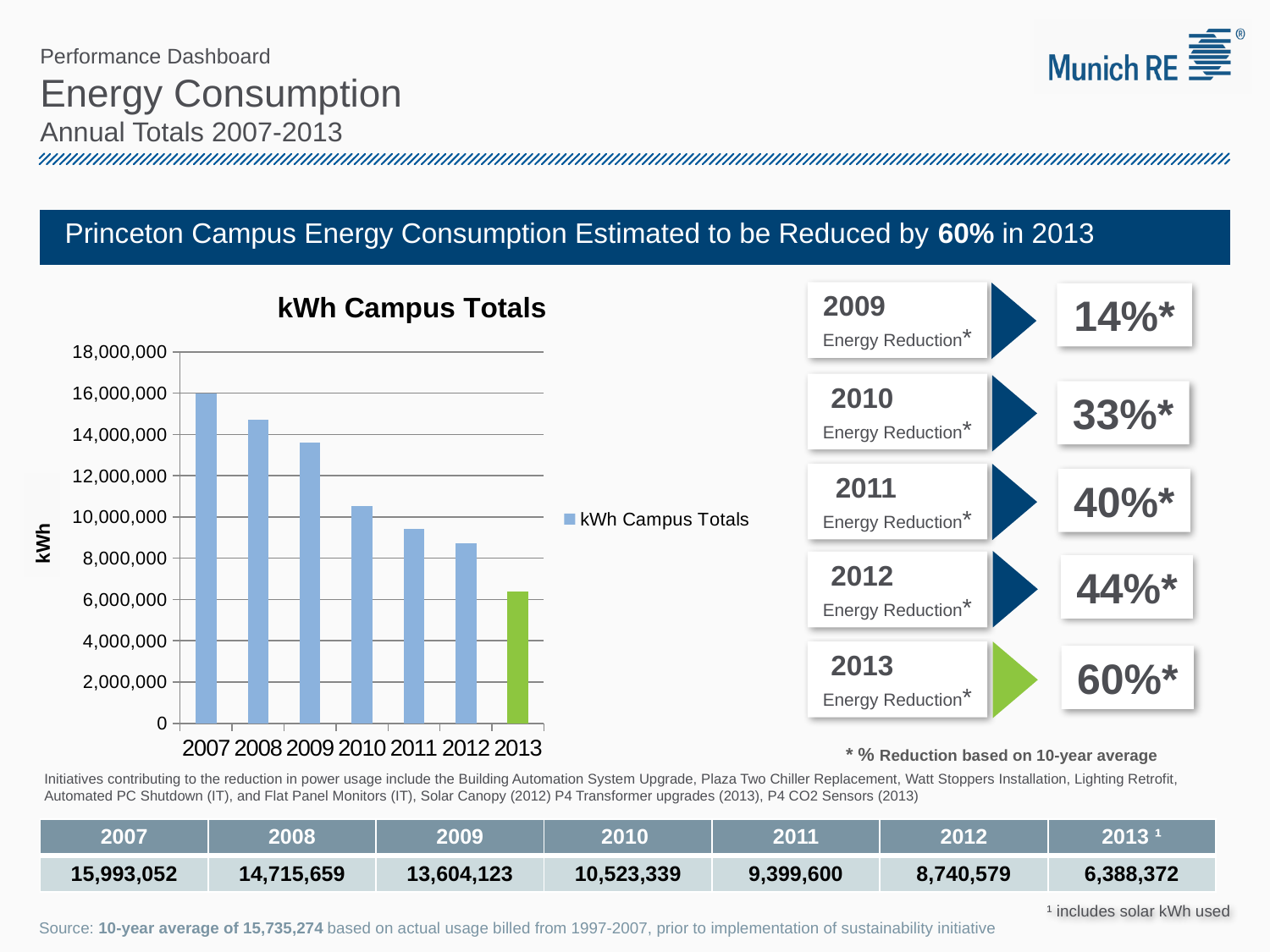
What colour is the bar for 2013 in the kWh Campus Totals chart? green How many series does the legend of the kWh Campus Totals chart list? 1 What is the kWh Campus Total for 2013 as printed on the slide? 6,388,372 What is the difference between the kWh Campus Totals for 2007 and 2013 as printed on the slide? 9,604,680 How many years are plotted in the kWh Campus Totals chart? 7 Is the kWh Campus Total for 2010 greater or less than 10,000,000? greater Do the kWh Campus Totals rise or fall from 2007 to 2013? fall Which year has the lowest kWh Campus Total? 2013 Which year has the highest kWh Campus Total? 2007 What kind of chart is shown on the slide? bar chart Which year has the larger kWh Campus Total, 2009 or 2011? 2009 Is the kWh Campus Total for 2012 greater or less than 10,000,000? less